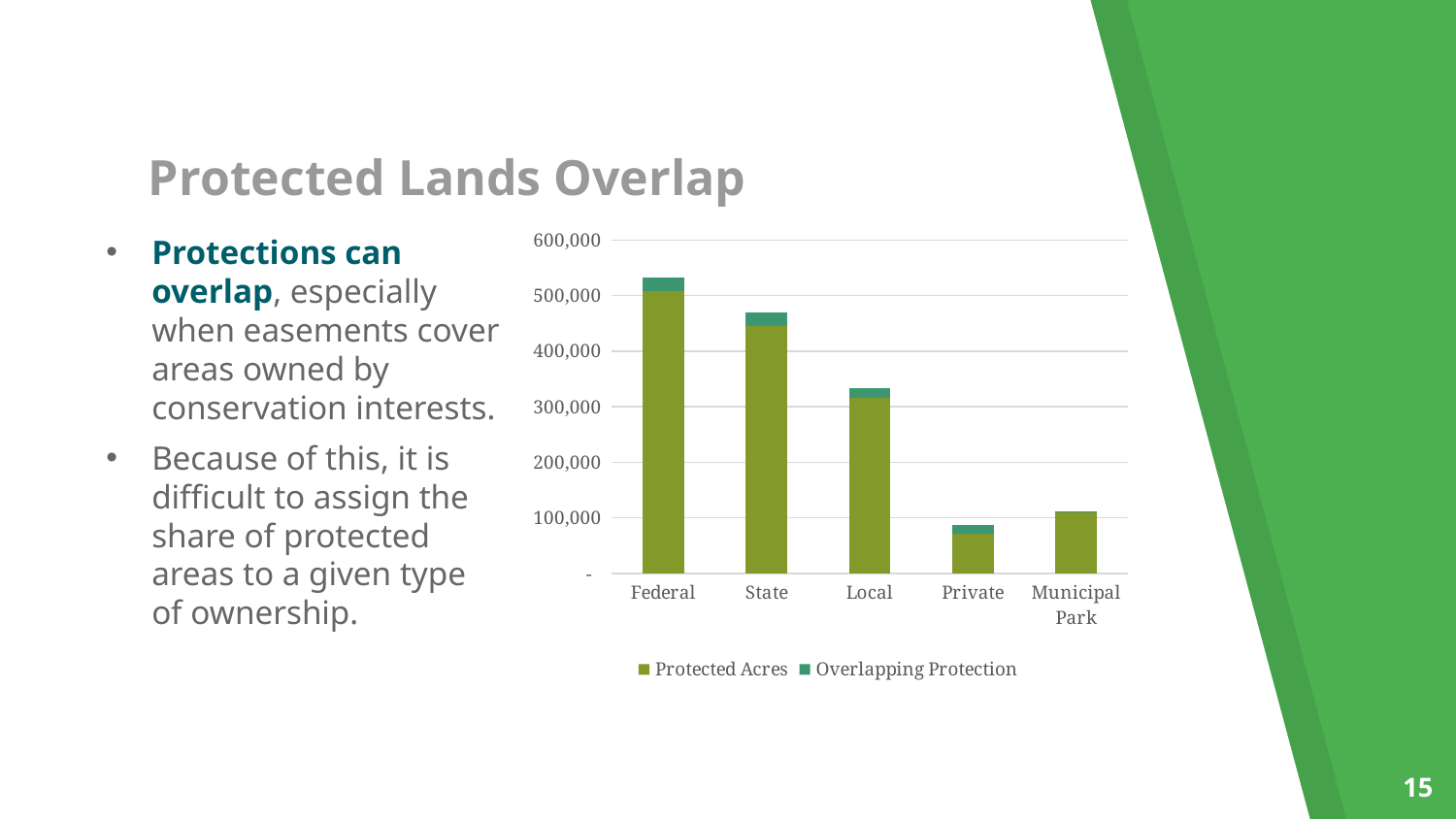
Which bar is taller, Federal or State? Federal How many series does the chart's legend list? 2 Which bar is taller, Local or Municipal Park? Local What kind of chart is shown on the slide? Stacked bar chart What are the two series named in the chart's legend? Protected Acres and Overlapping Protection Is the total height of the Private bar greater or less than 100,000? less Is the total height of the Federal bar greater or less than 500,000? greater Do the bar heights rise or fall going from Federal to Private along the x axis? fall Is the total height of the State bar greater or less than 500,000? less How many ownership categories are shown on the x axis of the chart? 5 Which category has the tallest bar in the chart? Federal Which category has the shortest bar in the chart? Private